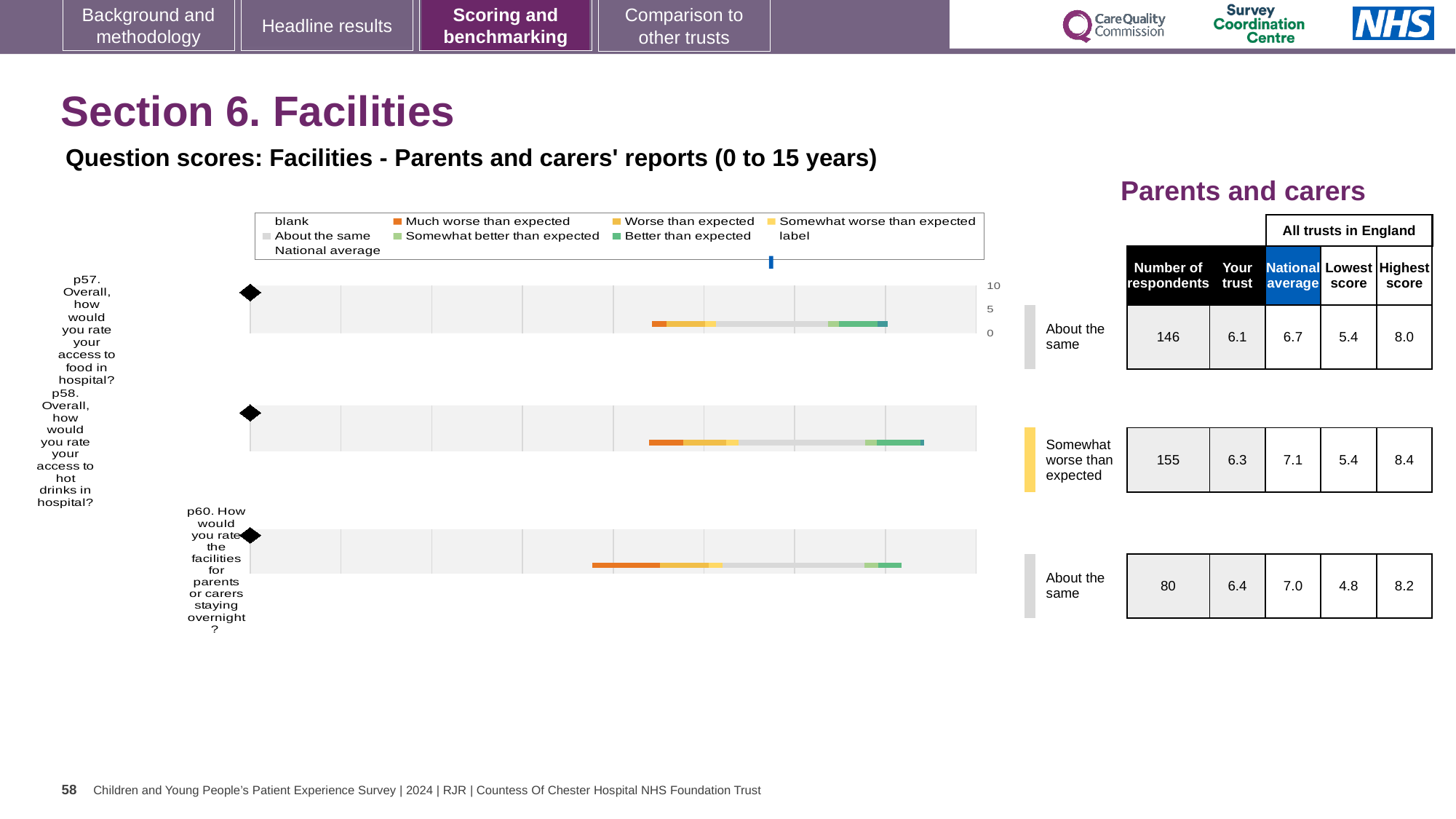
What is the 'Your trust' score for p57 (access to food in hospital)? 6.1 How many respondents answered p60 (facilities for parents or carers staying overnight)? 80 For p57, how much higher is the national average than the 'Your trust' score? 0.6 What colour represents 'Much worse than expected' in the legend? orange What kind of chart is used to show the question scores for Facilities? bar chart How many questions (rows) are plotted in the Facilities chart? 3 Which has the larger 'Your trust' score, p57 or p58? p58 Which question has the highest 'Your trust' score? p60 Which question has the lowest 'Lowest score' among all trusts in England? p60 What is the national average for p58 (access to hot drinks in hospital)? 7.1 Which benchmark category is p58 (access to hot drinks) placed in? Somewhat worse than expected What is the highest score among all trusts in England for p58? 8.4